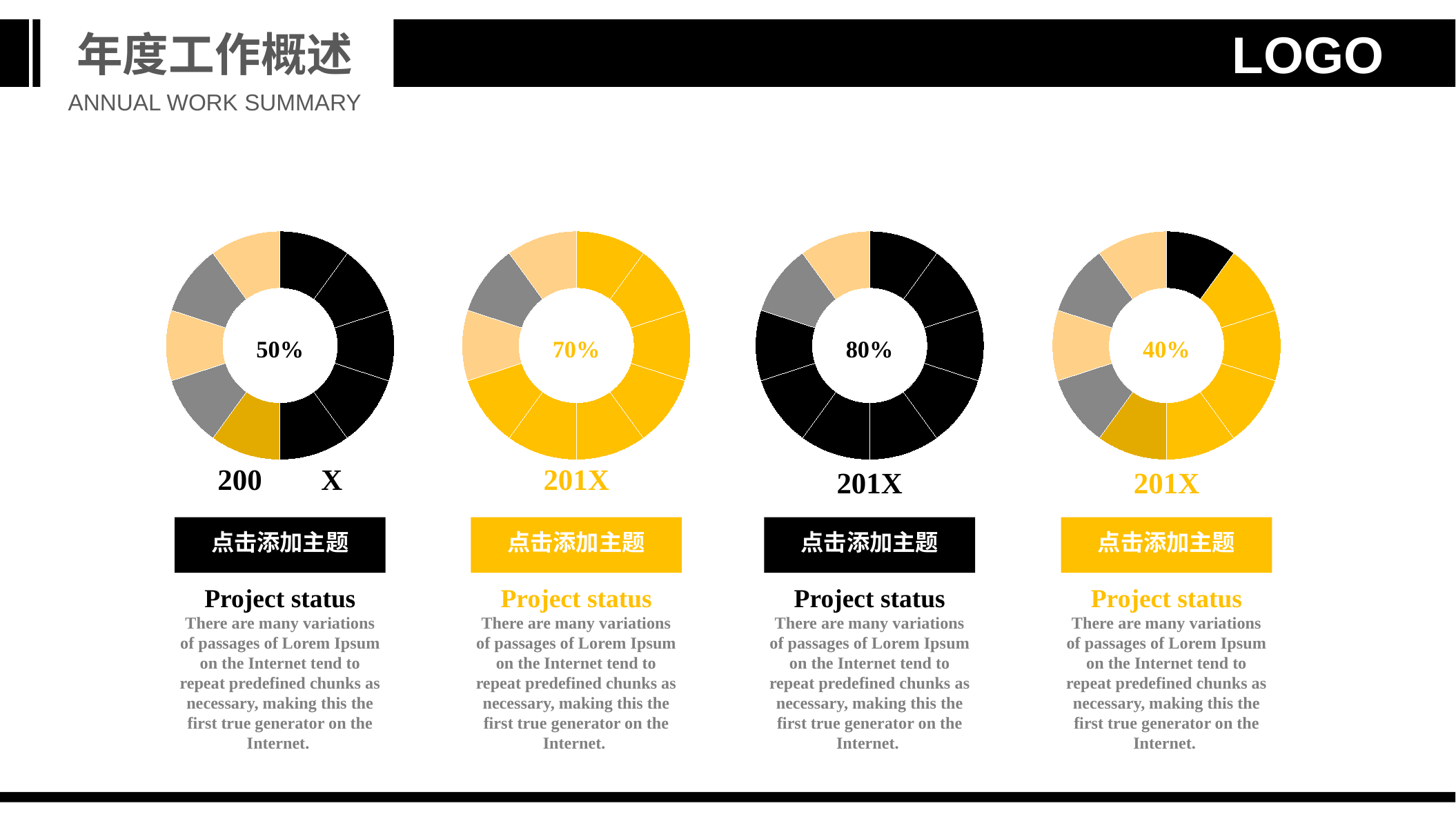
What percentage is shown in the centre of the leftmost chart (labelled 200 X)? 50% What kind of chart is used for each of the four charts on the slide? doughnut chart How many donut charts are shown on the slide? 4 What percentage is shown in the centre of the third chart from the left? 80% Which of the four charts shows the lowest percentage? the rightmost chart (40%) Which of the four charts shows the highest percentage? the third chart (80%) What percentage is shown in the centre of the second chart from the left? 70% What percentage is shown in the centre of the rightmost chart? 40% What colour is the filled portion of the second chart from the left? yellow Which shows a larger percentage, the leftmost chart or the second chart from the left? the second chart (70%) Is the percentage shown in the second chart from the left greater or less than 60%? greater What is the difference between the percentage in the third chart and the percentage in the rightmost chart? 40%